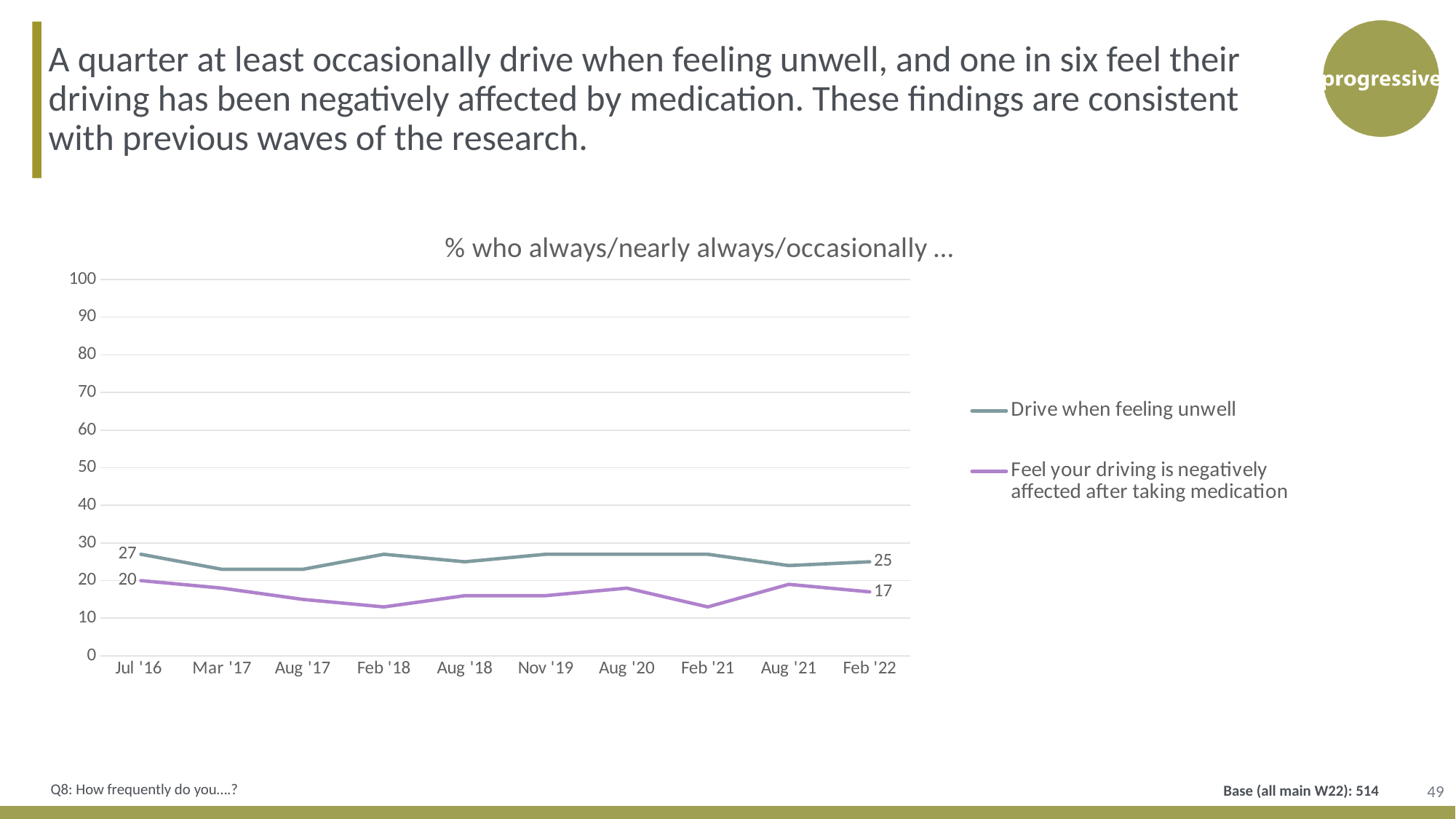
What is the value for 'Drive when feeling unwell' in Jul '16? 27 What is the value for 'Drive when feeling unwell' in Feb '22? 25 How many series does the legend list? 2 How many time points are shown on the x axis? 10 What is the value for 'Feel your driving is negatively affected after taking medication' in Jul '16? 20 What kind of chart is shown on the slide? line chart What is the title of the chart? % who always/nearly always/occasionally ... What is the difference between the two series in Feb '22? 8 What is the difference between the Jul '16 and Feb '22 values for 'Drive when feeling unwell'? 2 Which series is higher in Feb '22, 'Drive when feeling unwell' or 'Feel your driving is negatively affected after taking medication'? Drive when feeling unwell What is the value for 'Feel your driving is negatively affected after taking medication' in Feb '22? 17 Is the value for 'Drive when feeling unwell' in Feb '18 greater or less than 20? greater